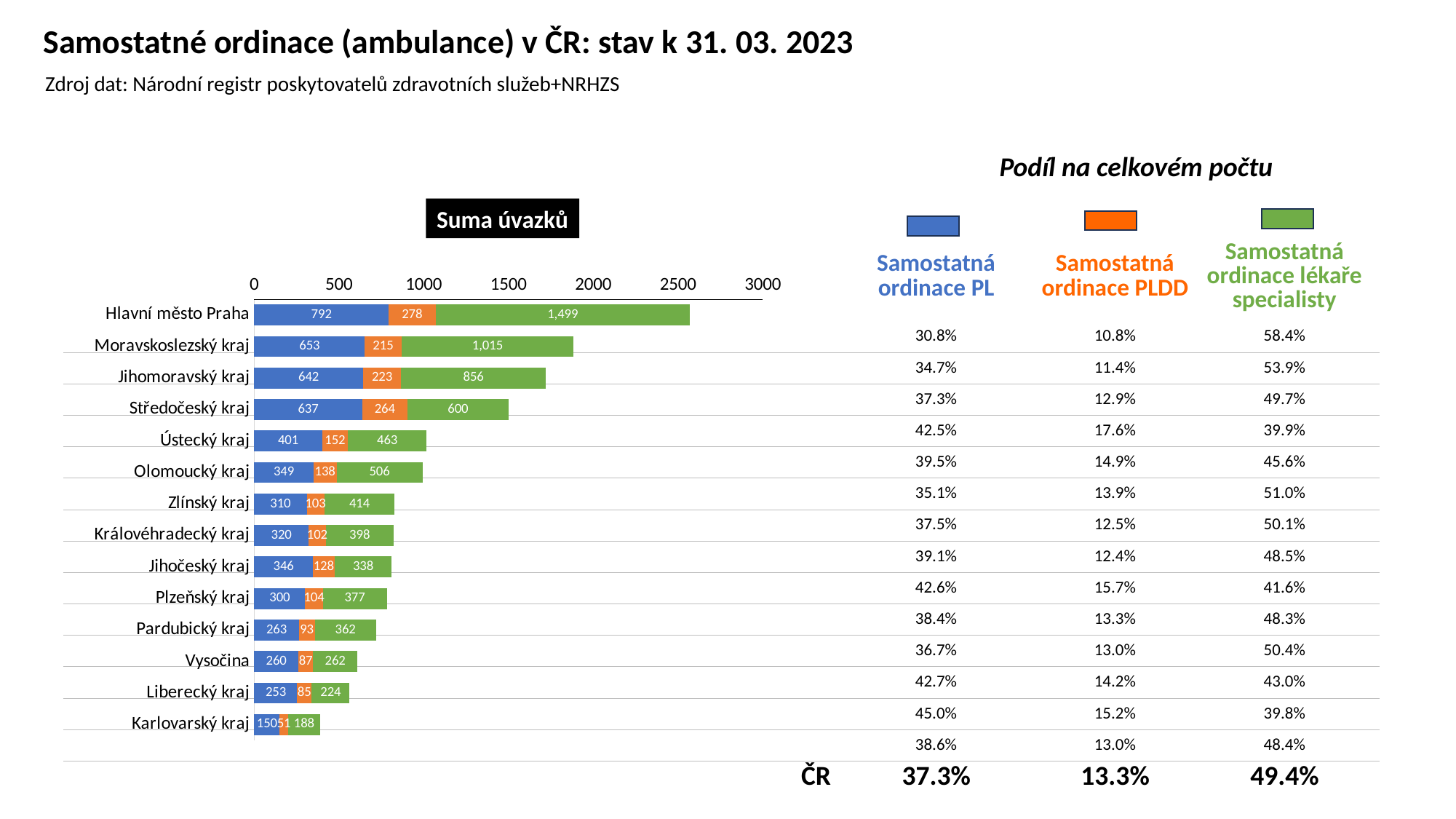
What is the ČR share shown for Samostatná ordinace PL in the "Podíl na celkovém počtu" table? 37.3% How many series does the legend of the "Suma úvazků" chart list? 3 What kind of chart is the "Suma úvazků" chart? bar chart In the "Suma úvazků" chart, which has the larger Samostatná ordinace PL value, Ústecký kraj or Olomoucký kraj? Ústecký kraj In the "Suma úvazků" chart, what is the total of the stacked bar for Hlavní město Praha? 2,569 In the "Suma úvazků" chart, what is the value of Samostatná ordinace PL for Hlavní město Praha? 792 In the "Suma úvazků" chart, what is the difference between the Samostatná ordinace lékaře specialisty values for Hlavní město Praha and Moravskoslezský kraj? 484 In the "Suma úvazků" chart, what is the value of Samostatná ordinace PLDD for Středočeský kraj? 264 In the "Suma úvazků" chart, which region has the lowest value for Samostatná ordinace lékaře specialisty? Karlovarský kraj How many regions are listed on the "Suma úvazků" chart? 14 In the "Suma úvazků" chart, which region has the highest value for Samostatná ordinace PL? Hlavní město Praha In the "Suma úvazků" chart, what is the value of Samostatná ordinace lékaře specialisty for Moravskoslezský kraj? 1,015